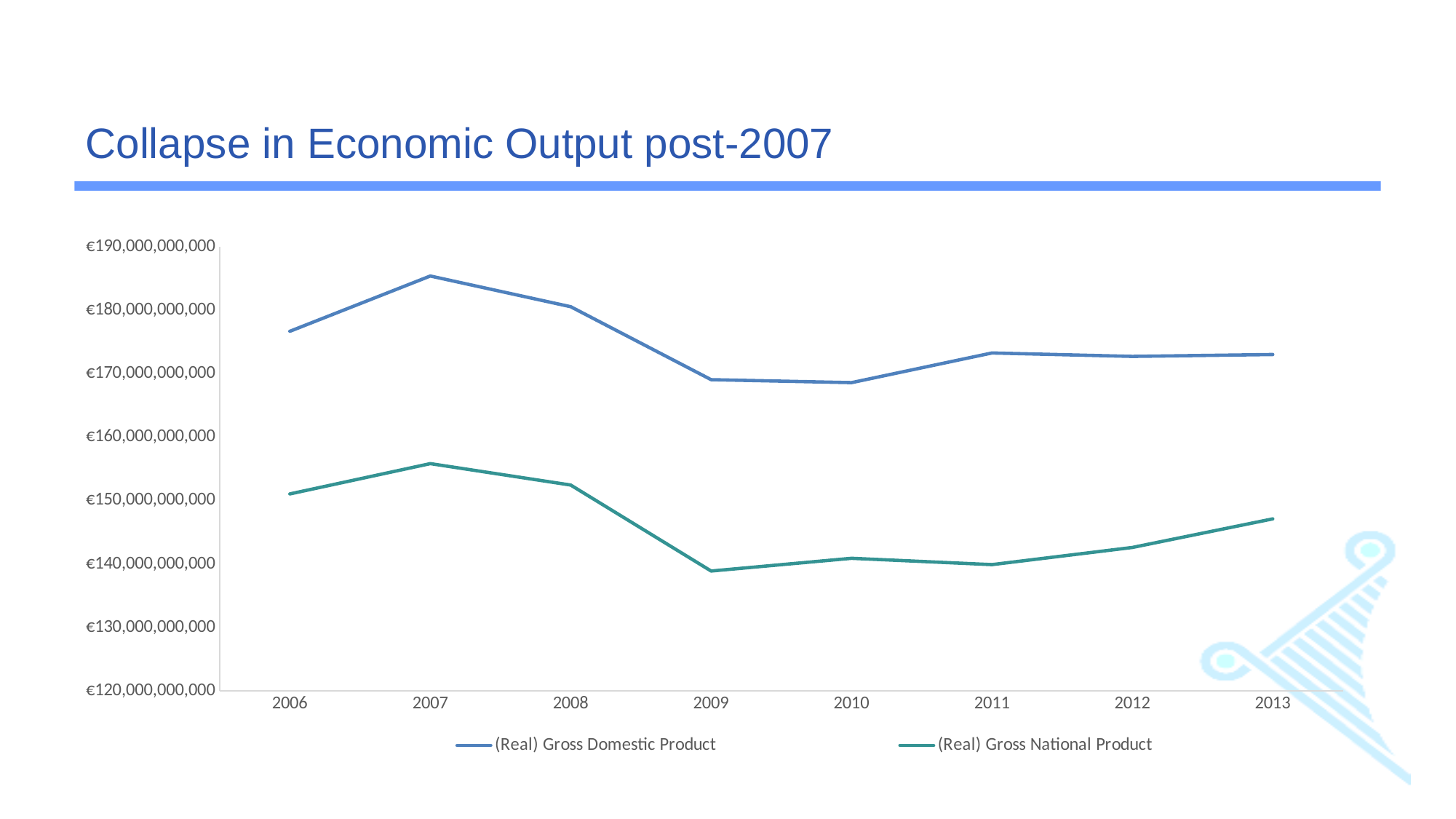
Is the value for (Real) Gross Domestic Product in 2007 greater or less than €180,000,000,000? greater Which series has the larger value in 2010, (Real) Gross Domestic Product or (Real) Gross National Product? (Real) Gross Domestic Product How many series does the legend list? 2 What is the title of the slide? Collapse in Economic Output post-2007 Is the value for (Real) Gross National Product in 2009 greater or less than €140,000,000,000? less In which year does (Real) Gross Domestic Product reach its highest value? 2007 What kind of chart is shown on the slide? line chart How many years are plotted along the x axis? 8 Is the value for (Real) Gross Domestic Product in 2013 greater or less than €170,000,000,000? greater In which year does (Real) Gross National Product reach its highest value? 2007 Does (Real) Gross Domestic Product rise or fall between 2007 and 2009? fall